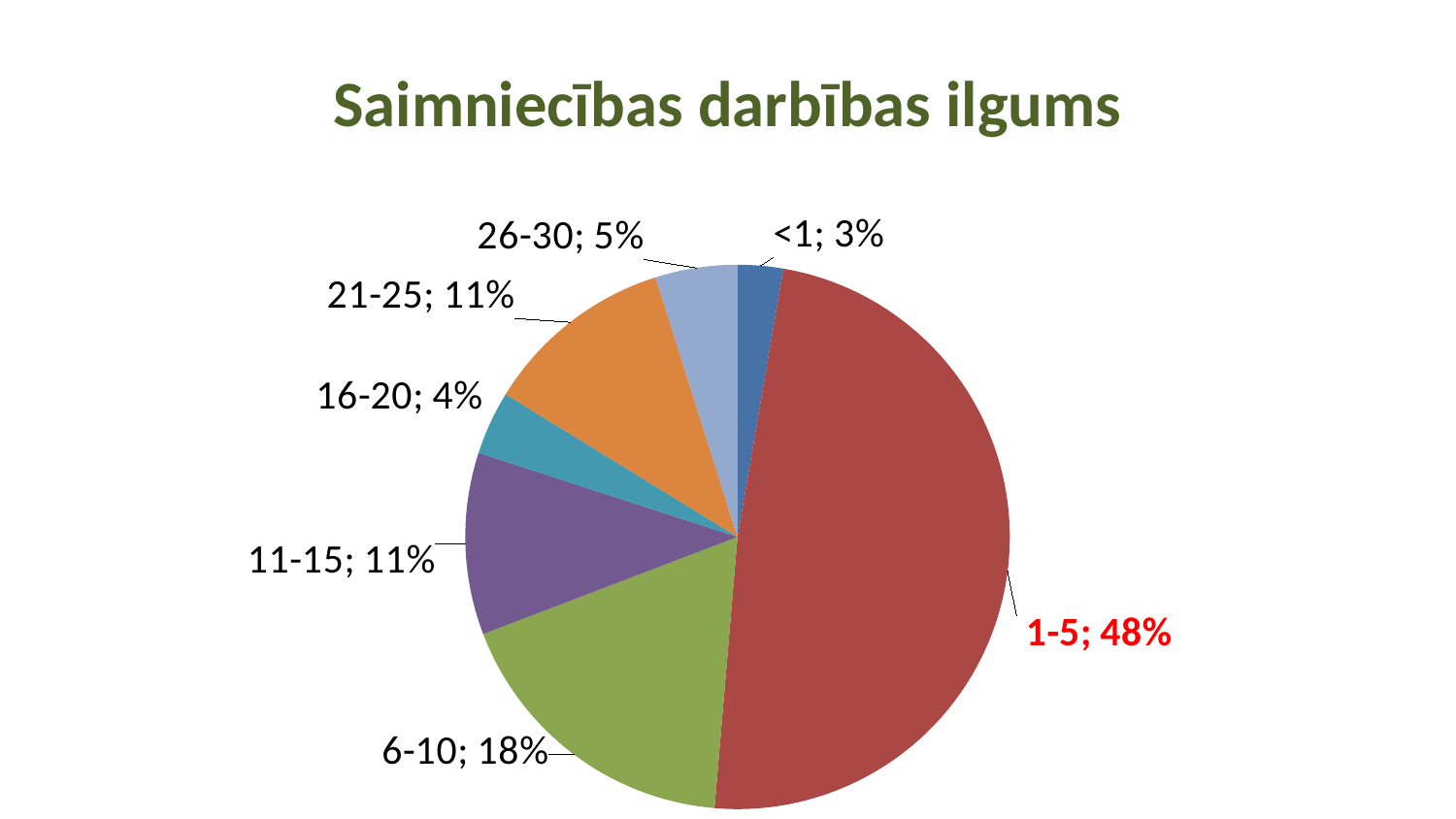
What kind of chart is shown on the slide? pie chart Which category has the smallest share of the pie? <1 What is the value for the <1 category? 3% Which category has the largest share of the pie? 1-5 What is the value for the 16-20 category? 4% What is the value for the 6-10 category? 18% Which is larger, the share for 26-30 or the share for 16-20? 26-30 What share of the pie does the 1-5 category have? 48% What is the title of the chart? Saimniecības darbības ilgums How many slices does the pie chart have? 7 What is the difference between the shares of the 1-5 and 6-10 categories? 30 percentage points Which category's data label is shown in red? 1-5